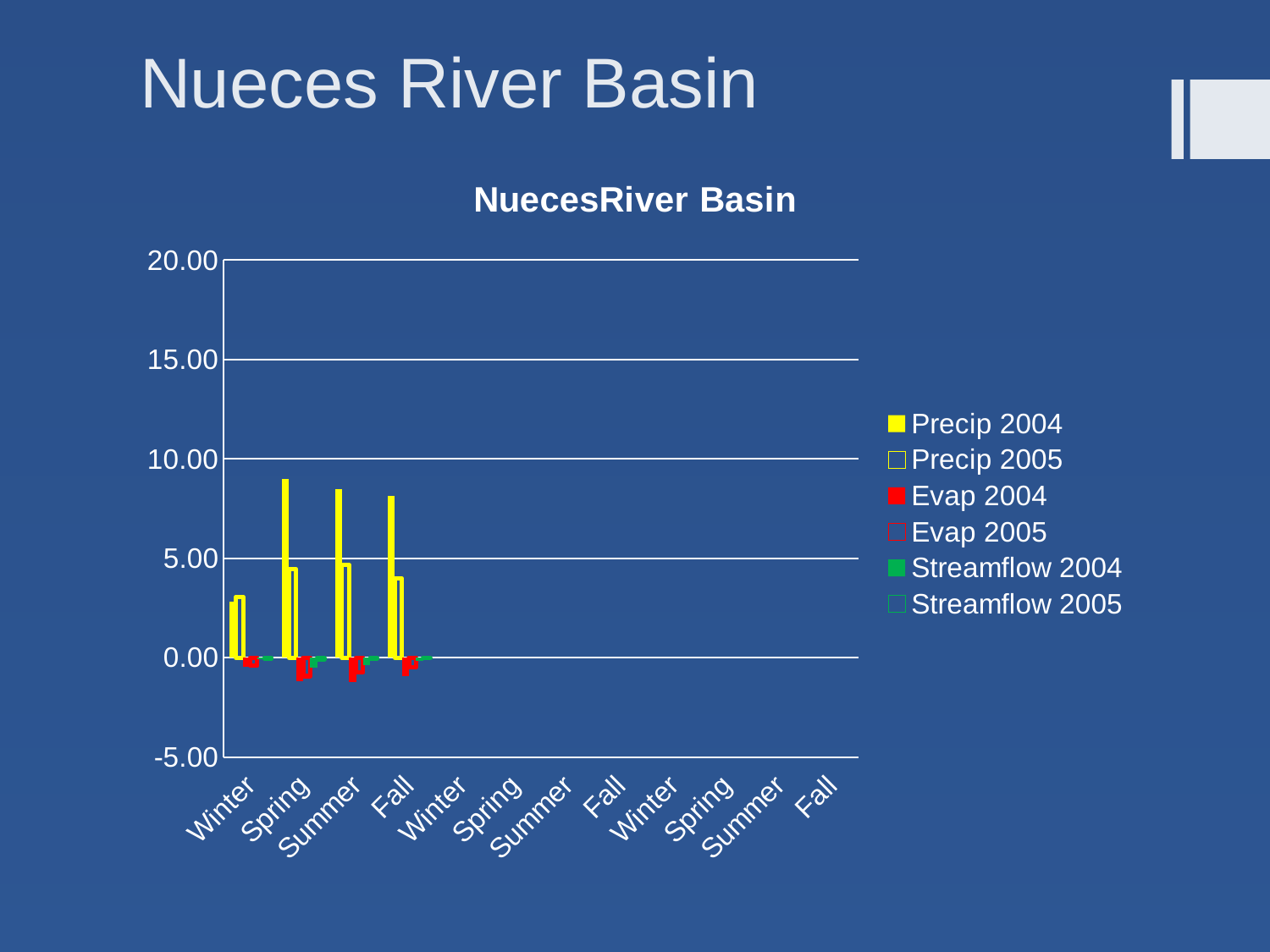
Is the Evap 2004 value for the first Spring greater or less than 0.00? less In the first Summer, which is larger: Precip 2004 or Precip 2005? Precip 2004 What kind of chart is shown on the slide? bar chart How many series does the legend list? 6 Is the Precip 2004 value for the first Winter greater or less than 5.00? less Which colour represents Precip 2004 in the legend? yellow Which is larger for Precip 2004: the first Spring or the first Winter? Spring Is the Precip 2005 value for the first Winter greater or less than 5.00? less How many category labels are shown along the x axis? 12 What is the title of the chart? NuecesRiver Basin Among the first four seasons, in which season is the Precip 2004 bar lowest? Winter